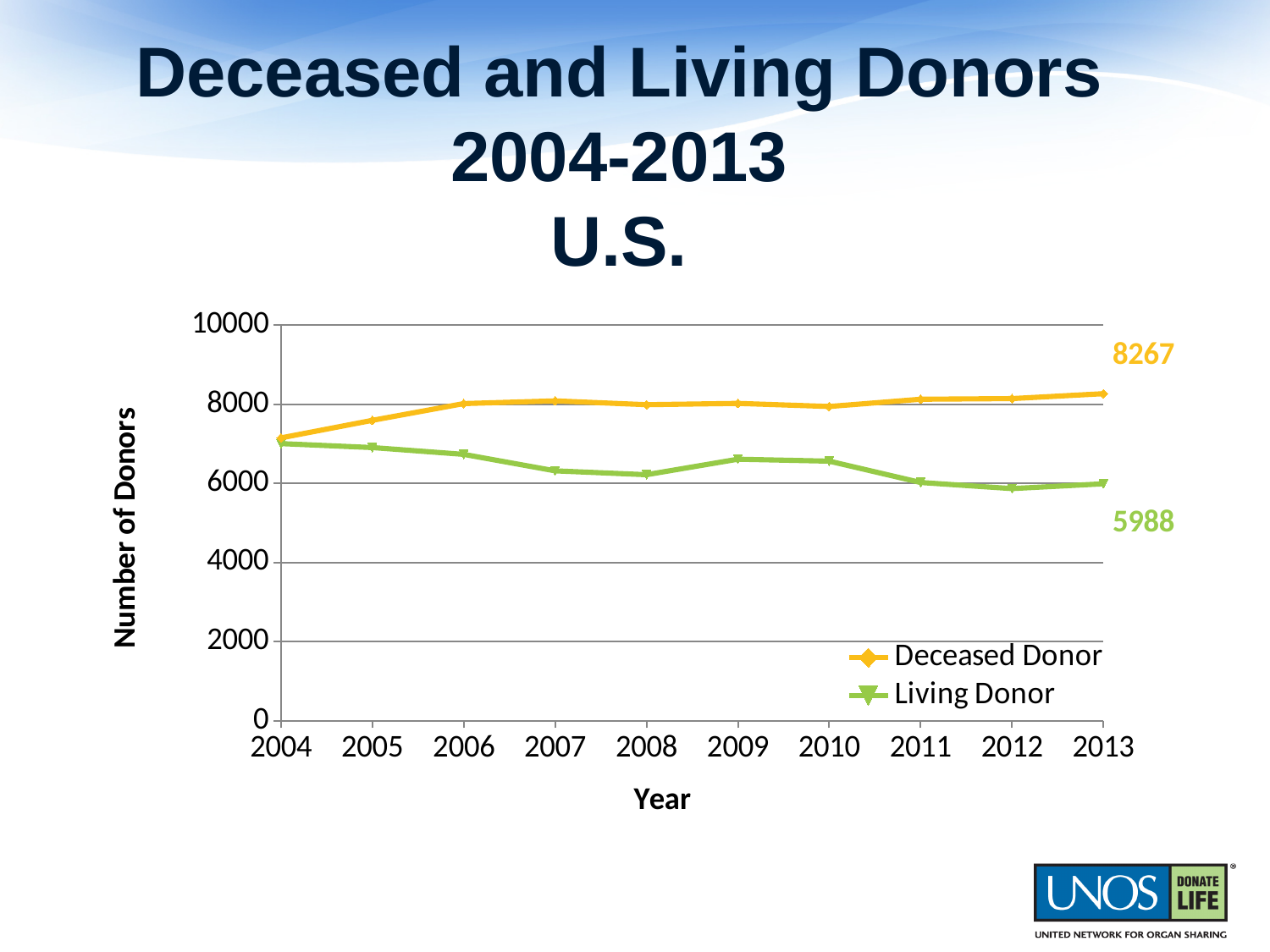
What kind of chart is shown on the slide? line chart Does the Living Donor series rise or fall from 2004 to 2013? fall What is the label on the y axis? Number of Donors How many years are shown on the x axis? 10 Is the value for Living Donor in 2008 greater or less than 8000? less Is the value for Deceased Donor in 2004 greater or less than 8000? less Is the value for Living Donor in 2004 greater or less than 8000? less What is the difference between the Deceased Donor and Living Donor values in 2013? 2279 What is the value for Deceased Donor in 2013? 8267 In 2013, which series has the larger value, Deceased Donor or Living Donor? Deceased Donor What is the value for Living Donor in 2013? 5988 How many series does the legend list? 2